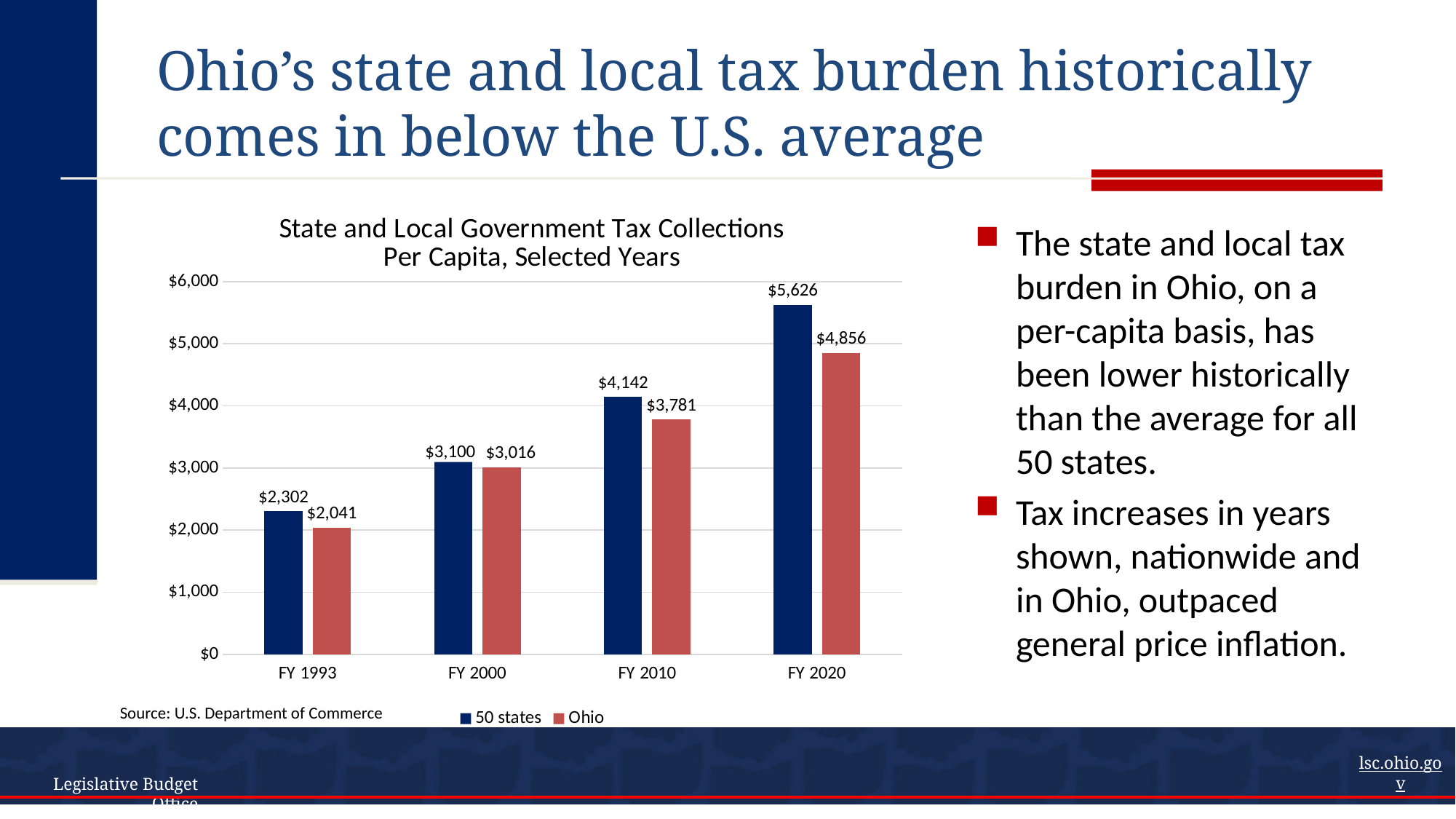
What is the value for Ohio in FY 1993? $2,041 What is the difference between the 50 states value and the Ohio value in FY 2020? $770 What is the value for Ohio in FY 2010? $3,781 What kind of chart is shown on the slide? Bar chart What is the difference between the 50 states value and the Ohio value in FY 2000? $84 In which fiscal year is the Ohio value lowest? FY 1993 Do the Ohio values rise or fall from FY 1993 to FY 2020? Rise In which fiscal year is the 50 states value highest? FY 2020 Which is larger in FY 2010, the 50 states value or the Ohio value? 50 states How many series does the legend list? 2 What is the value for 50 states in FY 2020? $5,626 How many fiscal years are shown on the x axis? 4